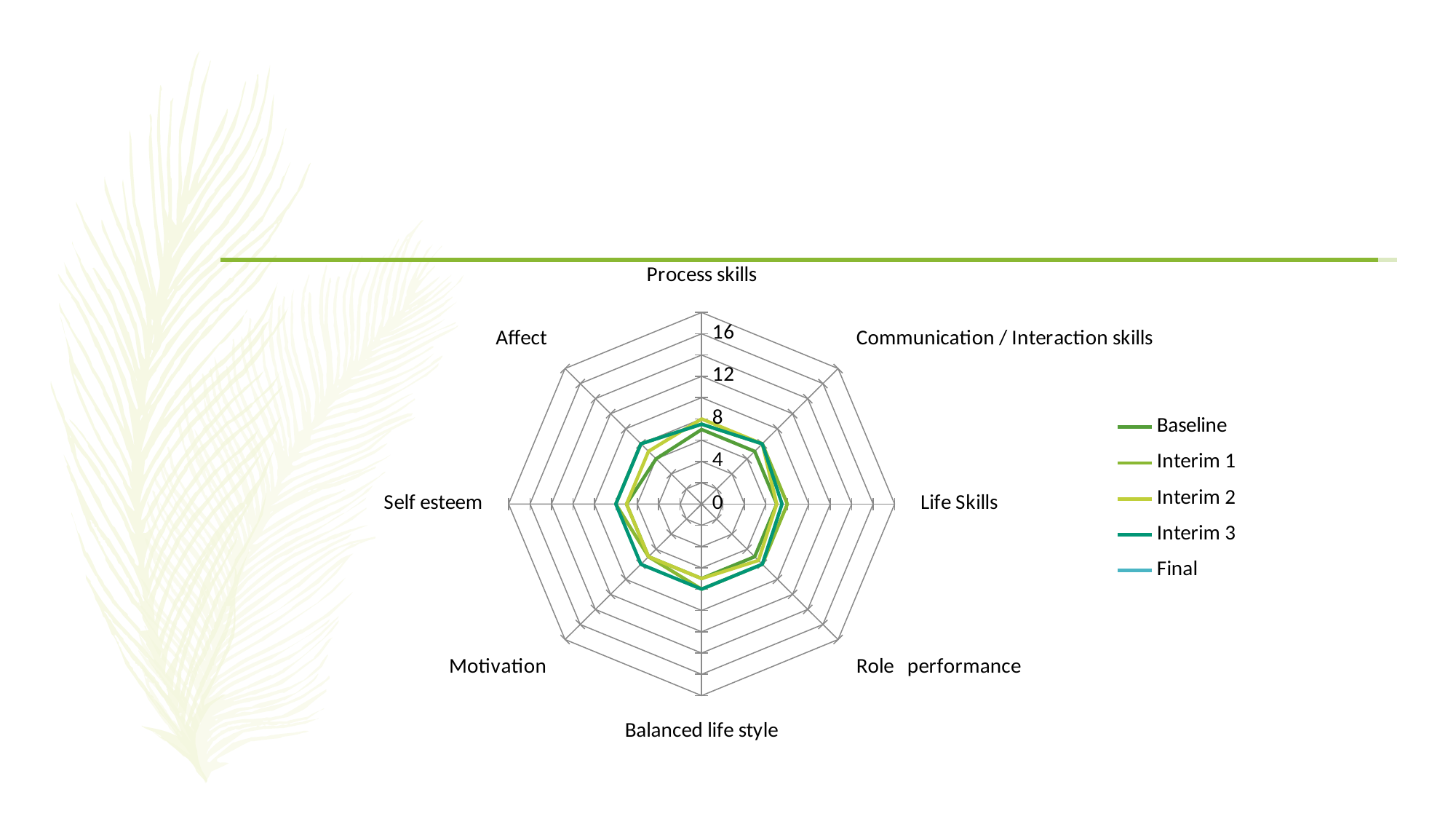
Is the Baseline value for Life Skills greater or less than 12? less What are the series names listed in the legend? Baseline, Interim 1, Interim 2, Interim 3, Final How many categories (axes) does the radar chart have? 8 What kind of chart is shown on the slide? Radar chart Which category is positioned at the top of the radar chart? Process skills Is the Interim 3 value for Self esteem greater or less than 4? greater How many series does the legend list? 5 What is the highest value shown on the radar chart's axis scale? 16 Is the Baseline value for Motivation greater or less than 12? less